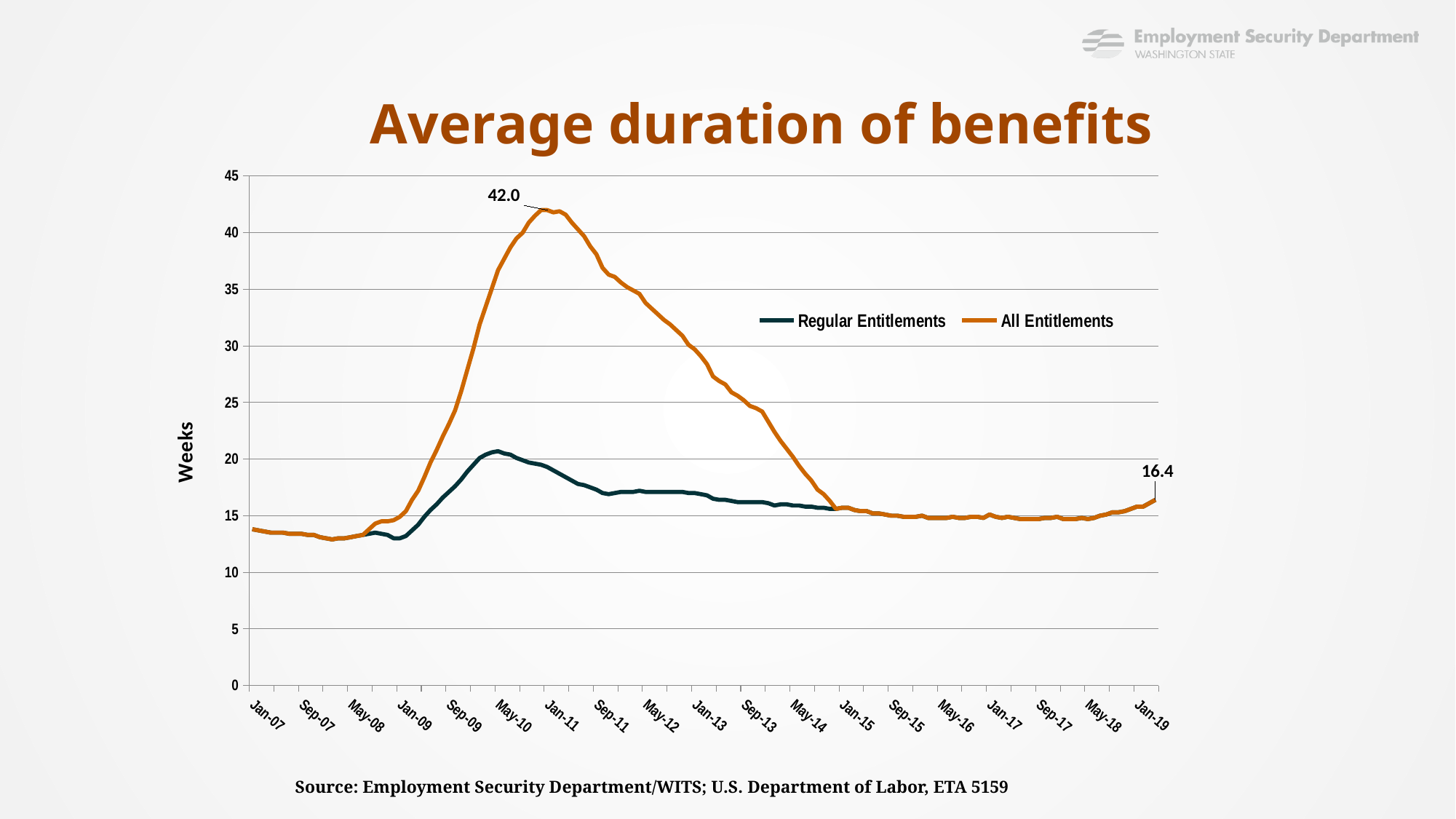
What is the peak value labelled on the All Entitlements line? 42.0 What value is labelled at Jan-19 at the right end of the chart? 16.4 How many series does the legend list? 2 What is the title of the vertical axis? Weeks Is the Regular Entitlements value at Sep-11 greater or less than 20? less Is the All Entitlements value at Jan-07 greater or less than 15? less Does the All Entitlements line rise or fall between Jan-11 and May-14? fall At Jan-11, which series has the higher value, Regular Entitlements or All Entitlements? All Entitlements What kind of chart is shown on the slide? line chart What are the two series named in the legend? Regular Entitlements and All Entitlements Is the All Entitlements value at Jan-13 greater or less than 25? greater What is the difference between the labelled peak of 42.0 and the labelled Jan-19 value of 16.4? 25.6